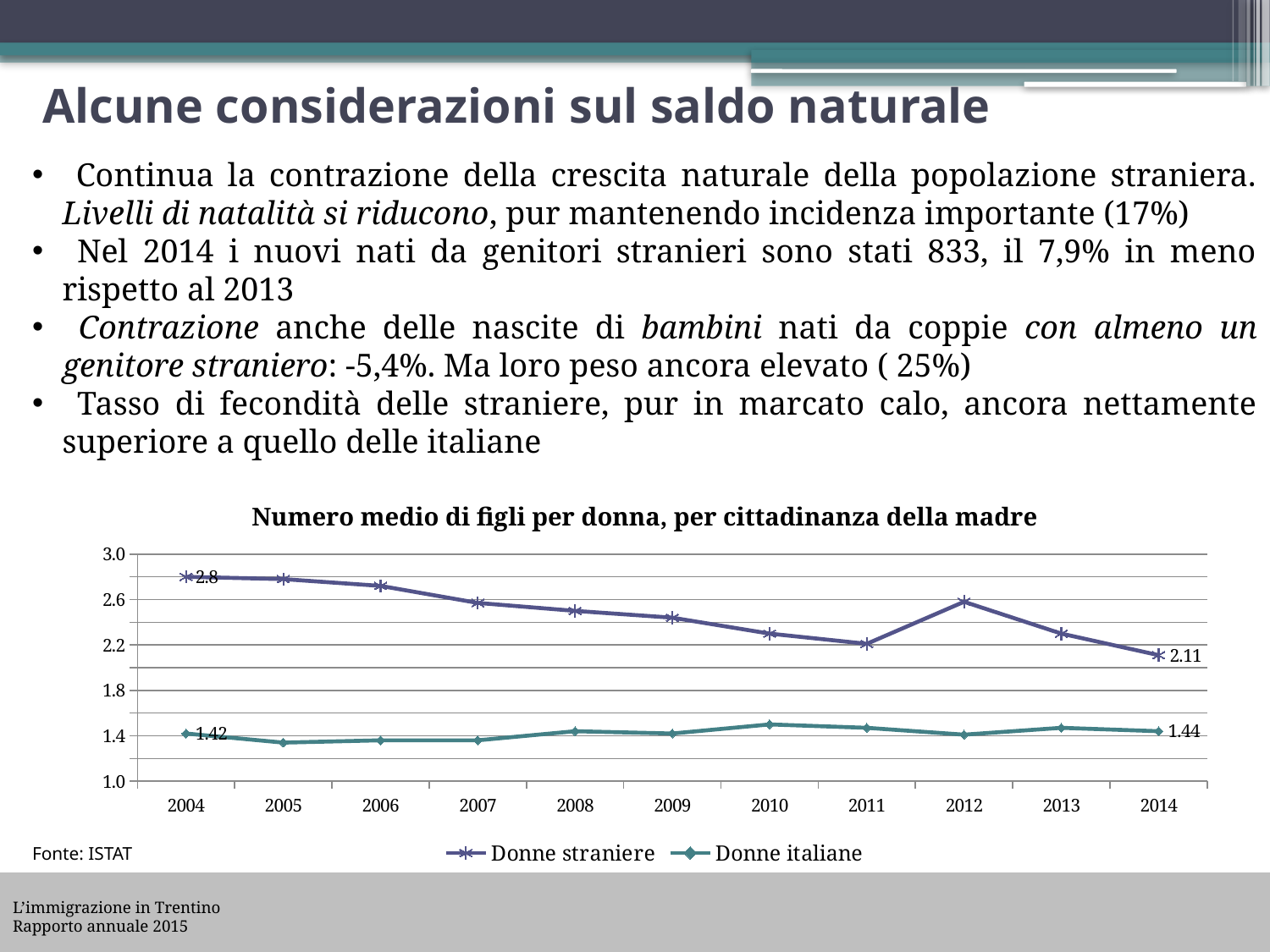
How many years are shown on the x axis of the chart? 11 By how much did the value for Donne straniere decrease from 2004 to 2014? 0.69 What is the value for Donne italiane in 2014? 1.44 Is the value for Donne italiane in 2010 greater or less than 1.8? less What is the difference between Donne straniere and Donne italiane in 2014? 0.67 What is the value for Donne straniere in 2014? 2.11 In 2014, which series has the higher value, Donne straniere or Donne italiane? Donne straniere What is the value for Donne italiane in 2004? 1.42 What type of chart is shown on the slide? Line chart How many series does the chart legend list? 2 What is the value for Donne straniere in 2004? 2.8 Is the value for Donne straniere in 2012 greater or less than 2.2? greater